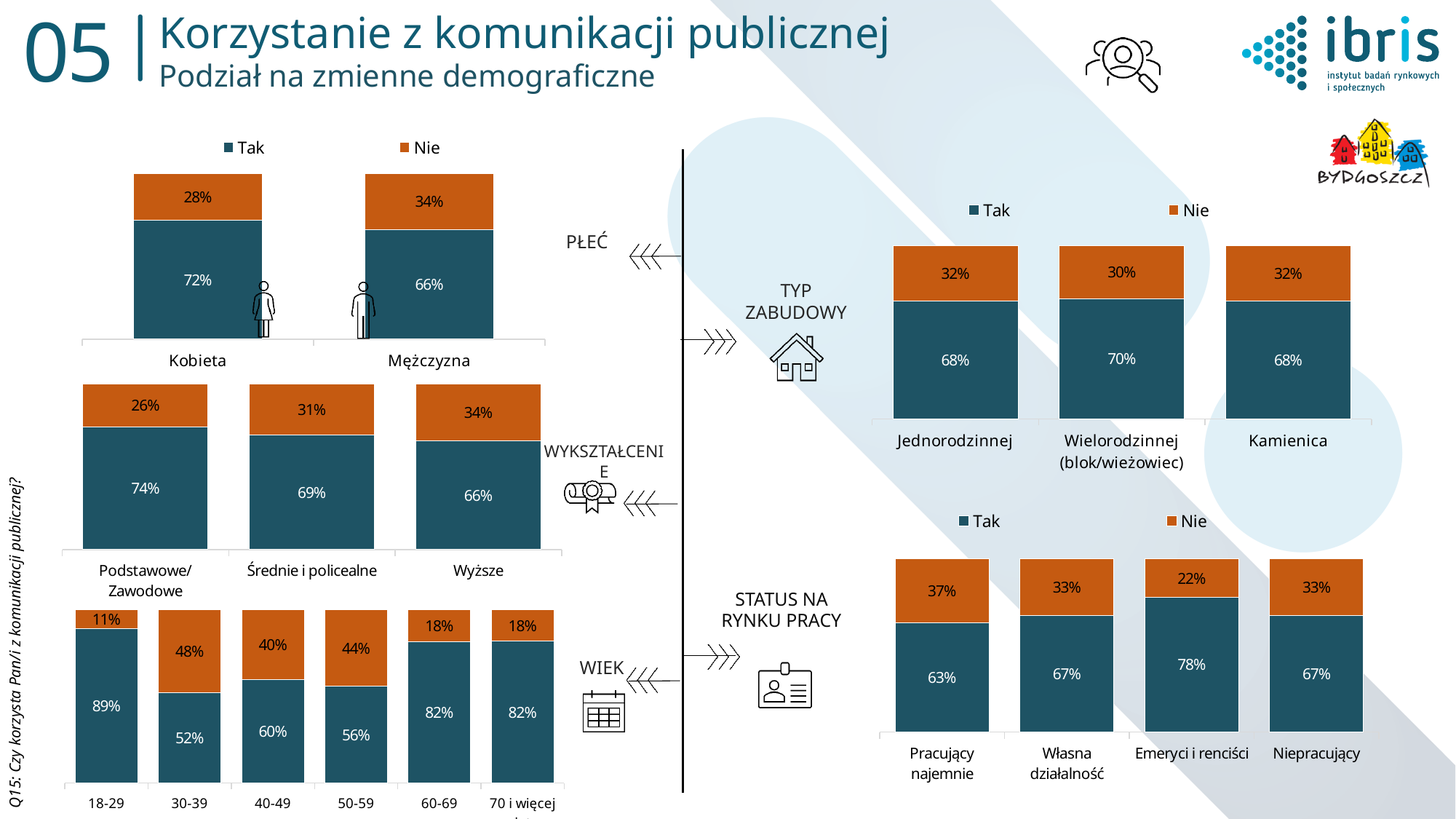
In the PŁEĆ (gender) chart, what is the 'Nie' value for Mężczyzna? 34% In the WYKSZTAŁCENIE (education) chart, what is the difference between the 'Tak' values for Podstawowe/Zawodowe and Wyższe? 8 percentage points In the TYP ZABUDOWY (building type) chart, what is the 'Tak' value for Wielorodzinnej (blok/wieżowiec)? 70% In the STATUS NA RYNKU PRACY (labor market status) chart, which category has the highest 'Tak' value? Emeryci i renciści How many age groups are shown in the WIEK (age) chart? 6 In the STATUS NA RYNKU PRACY chart, is the 'Tak' value for Pracujący najemnie larger or smaller than the 'Tak' value for Własna działalność? smaller In the TYP ZABUDOWY (building type) chart, what is the total of the stacked bar for Kamienica? 100% In the WIEK (age) chart, which age group has the lowest 'Tak' value? 30-39 How many series does the legend list in the STATUS NA RYNKU PRACY chart? 2 In the PŁEĆ (gender) chart, what is the 'Tak' value for Kobieta? 72% In the WYKSZTAŁCENIE (education) chart, which category has the highest 'Tak' value? Podstawowe/Zawodowe In the WIEK (age) chart, what is the 'Nie' value for the 40-49 group? 40%